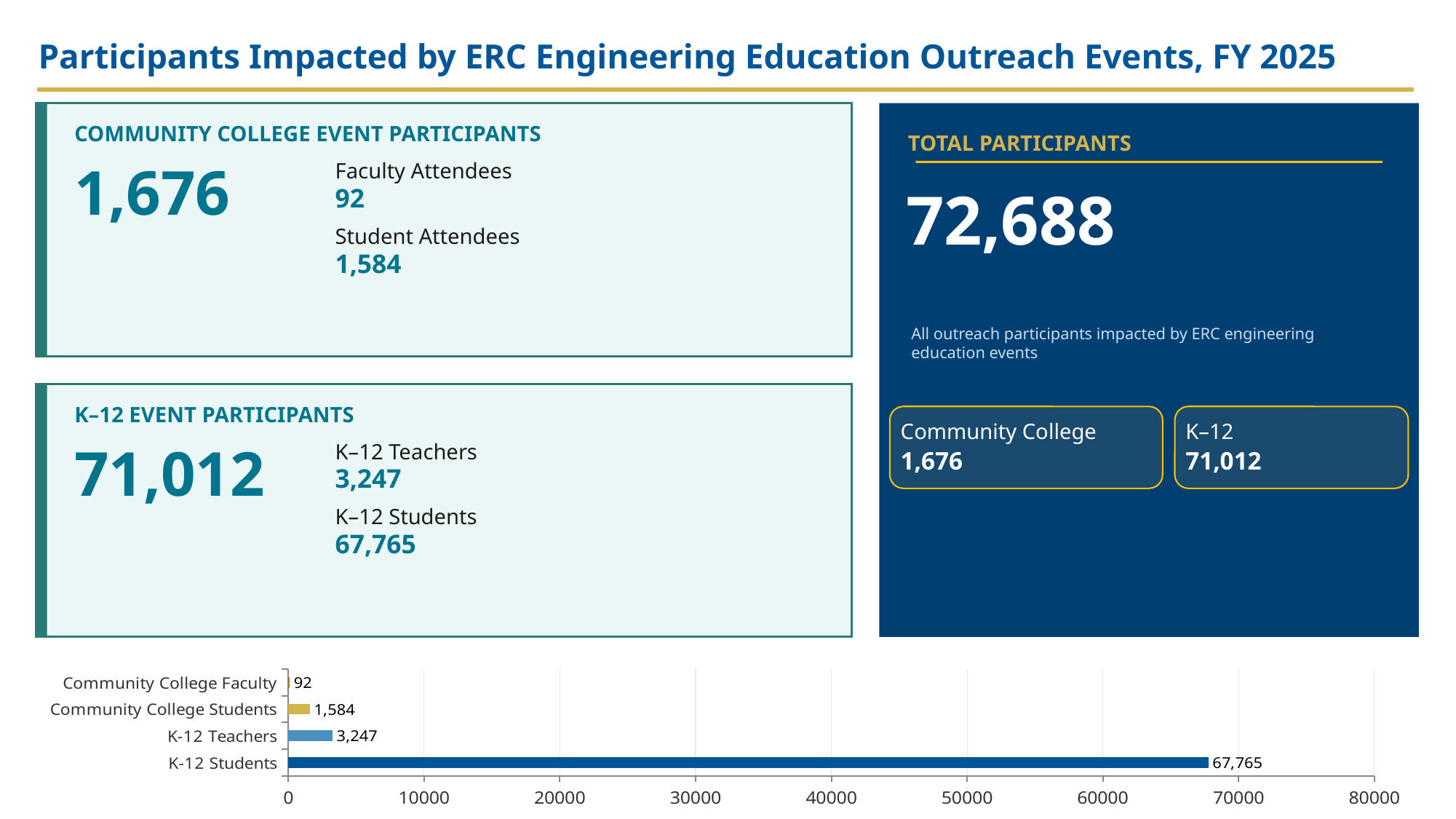
Is the value for K-12 Students in the bar chart greater or less than 60000? greater Which category has the lowest value in the bar chart? Community College Faculty How many categories does the bar chart show? 4 What is the highest value shown on the x axis of the bar chart? 80000 What is the value for Community College Students in the bar chart? 1,584 What kind of chart is shown at the bottom of the slide? bar chart What is the value for Community College Faculty in the bar chart? 92 Which is larger in the bar chart, K-12 Teachers or Community College Students? K-12 Teachers What is the difference between K-12 Students and K-12 Teachers in the bar chart? 64,518 What is the value for K-12 Teachers in the bar chart? 3,247 What is the value for K-12 Students in the bar chart? 67,765 Which category has the highest value in the bar chart? K-12 Students